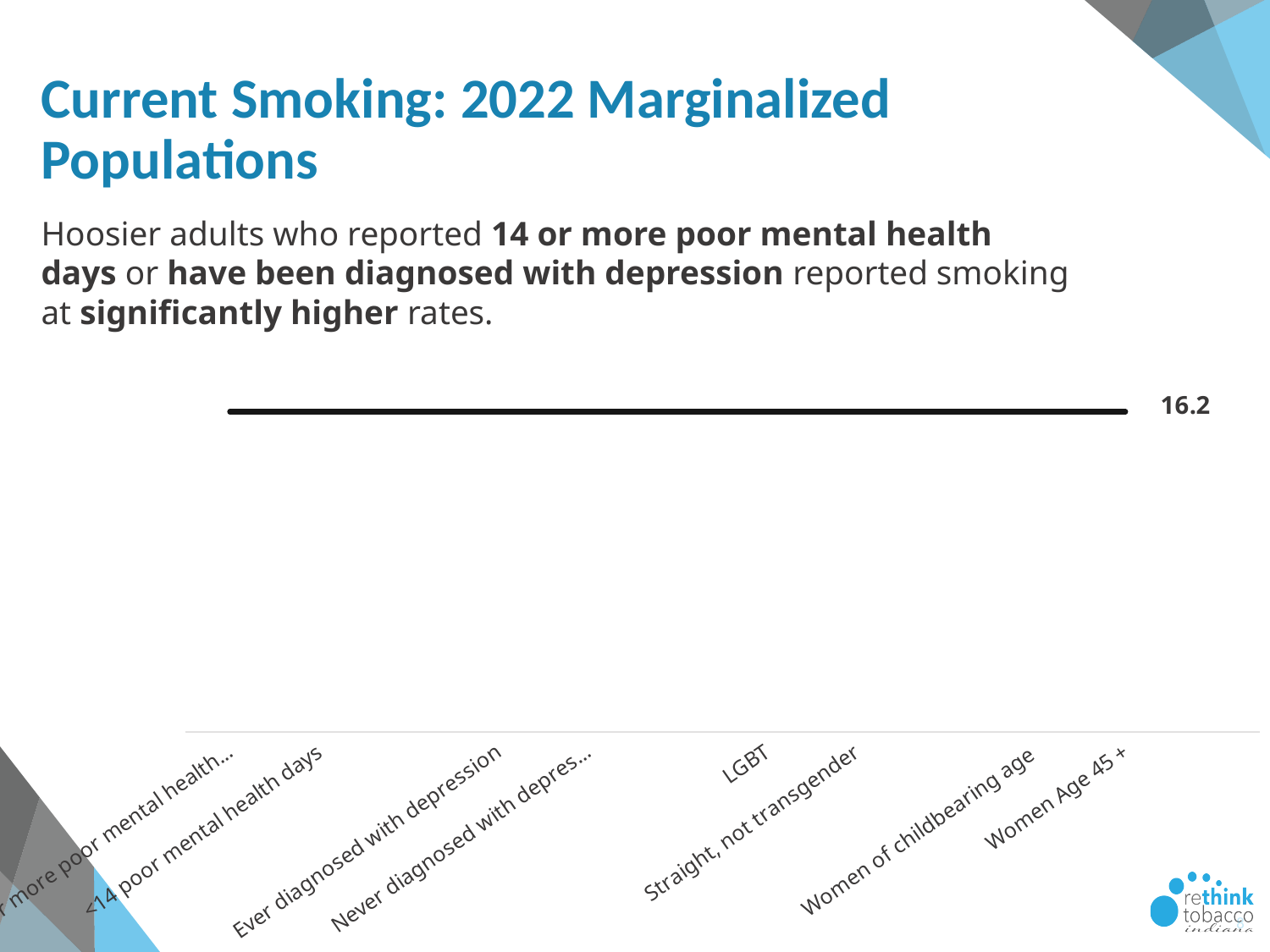
Which category label appears furthest to the right on the x axis? Women Age 45 + How many category labels are shown along the x axis of the chart? 8 What is the title of the slide containing the chart? Current Smoking: 2022 Marginalized Populations What value is printed at the right end of the horizontal line on the chart? 16.2